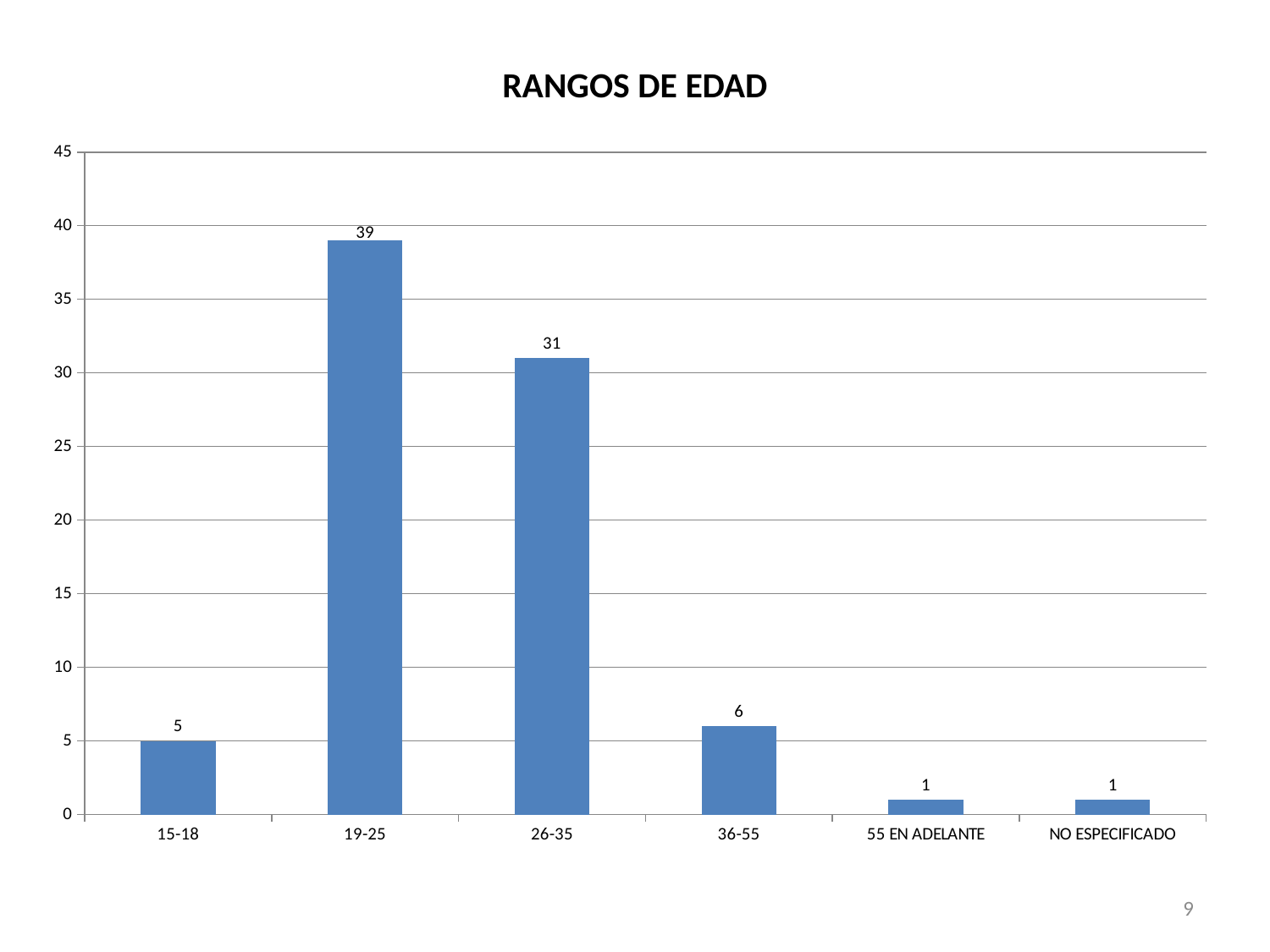
Which age range has the highest value? 19-25 What is the value for the 26-35 age range? 31 How many age range categories are shown on the x axis? 6 What kind of chart is shown on the slide? Bar chart Which is larger, the value for 15-18 or the value for 36-55? 36-55 What is the title of the chart? RANGOS DE EDAD Is the value for 26-35 greater or less than 30? greater What is the value for the 15-18 age range? 5 What is the value for 36-55? 6 What is the difference between the values for 19-25 and 26-35? 8 What is the value for the 19-25 age range? 39 What is the value for NO ESPECIFICADO? 1